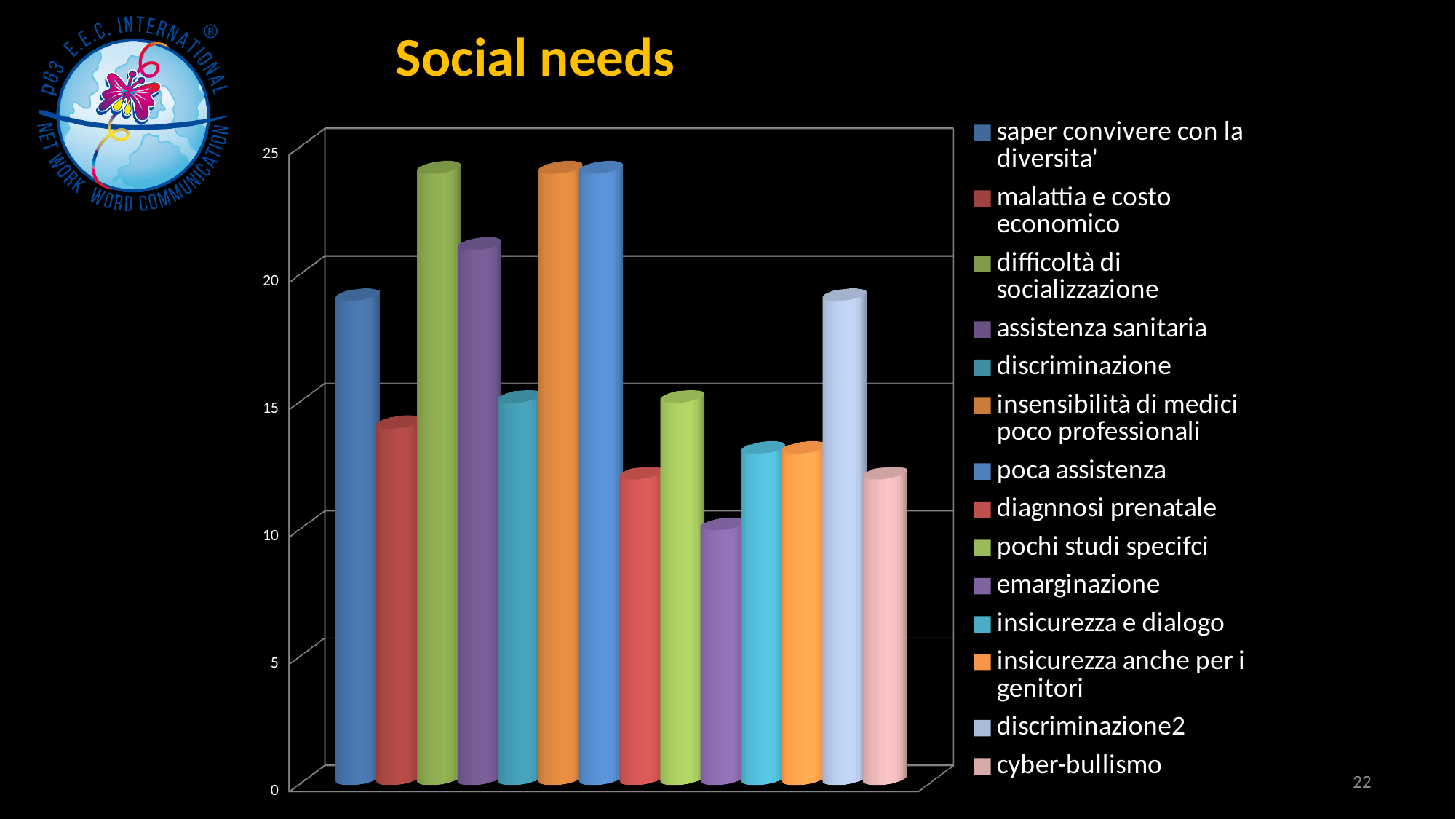
How many entries does the chart legend list? 14 Is the value for 'cyber-bullismo' greater or less than 15? less Is the value for 'saper convivere con la diversita'' greater or less than 15? greater Is the value for 'emarginazione' greater or less than 15? less Which is larger, the value for 'difficoltà di socializzazione' or for 'discriminazione'? difficoltà di socializzazione Which is larger, the value for 'assistenza sanitaria' or for 'emarginazione'? assistenza sanitaria What kind of chart is shown on the slide? bar chart What is the title of the chart? Social needs Which category has the lowest bar in the chart? emarginazione Which is larger, the value for 'saper convivere con la diversita'' or for 'malattia e costo economico'? saper convivere con la diversita' How many bars are plotted in the chart? 14